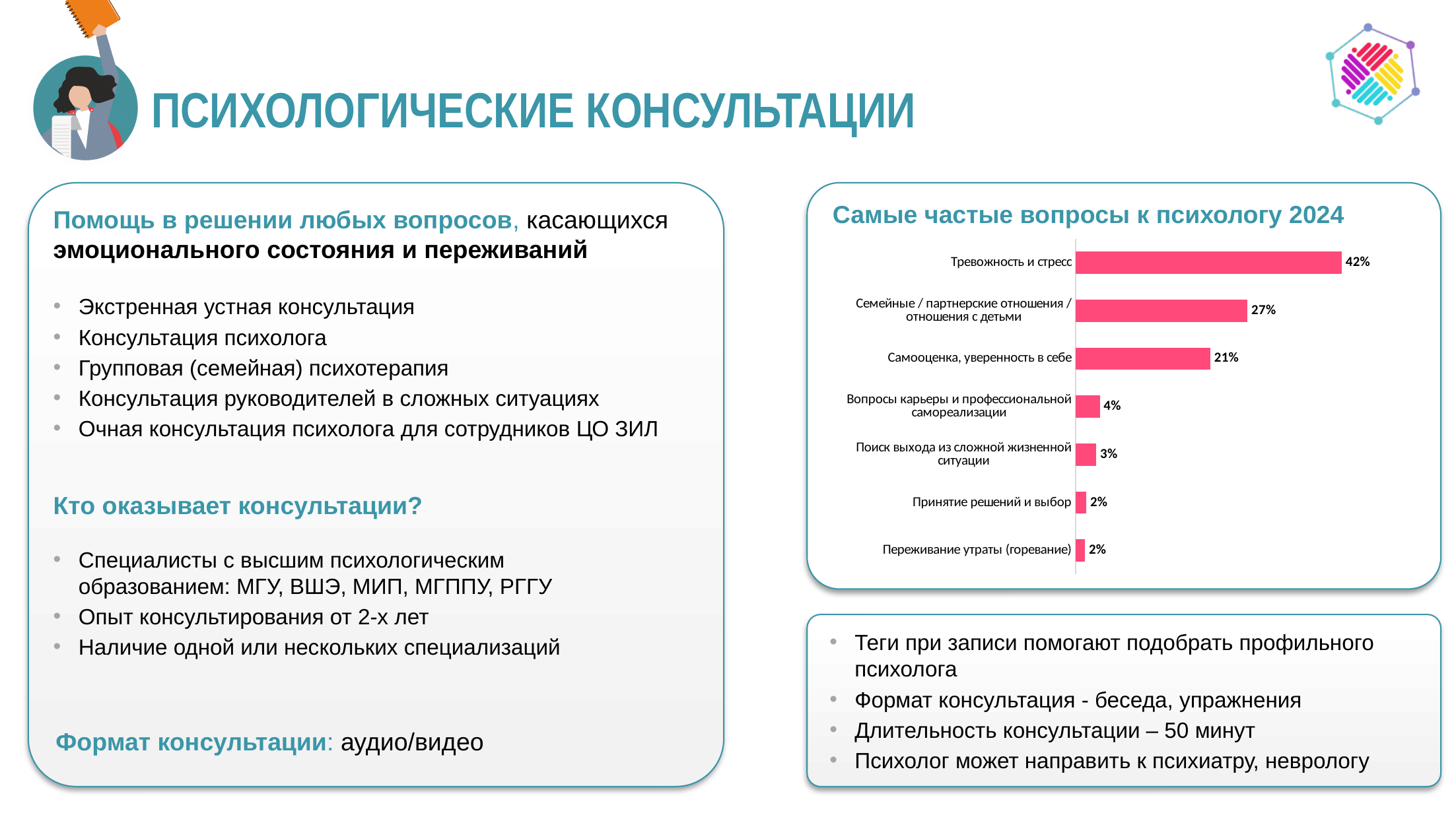
What is the value for "Вопросы карьеры и профессиональной самореализации" in the chart? 4% What is the value for "Тревожность и стресс" in the chart? 42% Which is larger: the value for "Вопросы карьеры и профессиональной самореализации" or the value for "Поиск выхода из сложной жизненной ситуации"? Вопросы карьеры и профессиональной самореализации How many categories are shown in the chart? 7 What is the value for "Семейные / партнерские отношения / отношения с детьми" in the chart? 27% What is the difference between the values for "Тревожность и стресс" and "Семейные / партнерские отношения / отношения с детьми"? 15% What is the value for "Самооценка, уверенность в себе" in the chart? 21% What kind of chart is shown on the slide? Bar chart What is the title of the chart on the slide? Самые частые вопросы к психологу 2024 Which category has the highest value in the chart? Тревожность и стресс What is the difference between the values for "Самооценка, уверенность в себе" and "Вопросы карьеры и профессиональной самореализации"? 17% What is the value for "Принятие решений и выбор" in the chart? 2%